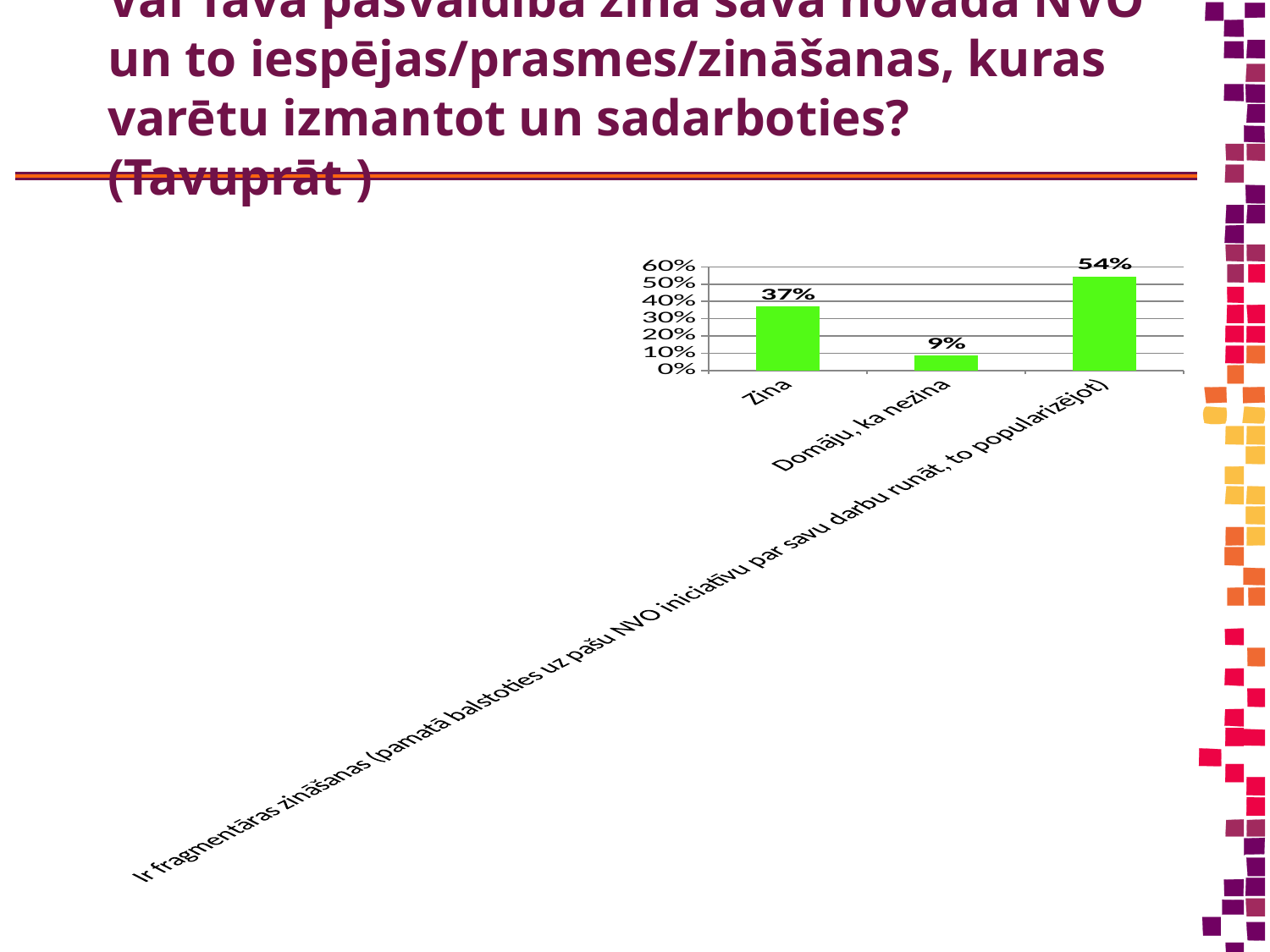
What is the value for "Zina"? 37% Is the value for "Zina" greater or less than 40%? less Which category has the highest value? Ir fragmentāras zināšanas (pamatā balstoties uz pašu NVO iniciatīvu par savu darbu runāt, to popularizējot) What is the difference between the values for "Zina" and "Domāju, ka nezina"? 28% What is the value for "Ir fragmentāras zināšanas (pamatā balstoties uz pašu NVO iniciatīvu par savu darbu runāt, to popularizējot)"? 54% What is the difference between the highest and lowest values in the chart? 45% Which category has the lowest value? Domāju, ka nezina What kind of chart is shown on the slide? bar chart What is the maximum value shown on the vertical axis? 60% Which is larger, the value for "Zina" or the value for "Domāju, ka nezina"? Zina How many categories are shown in the chart? 3 What is the value for "Domāju, ka nezina"? 9%